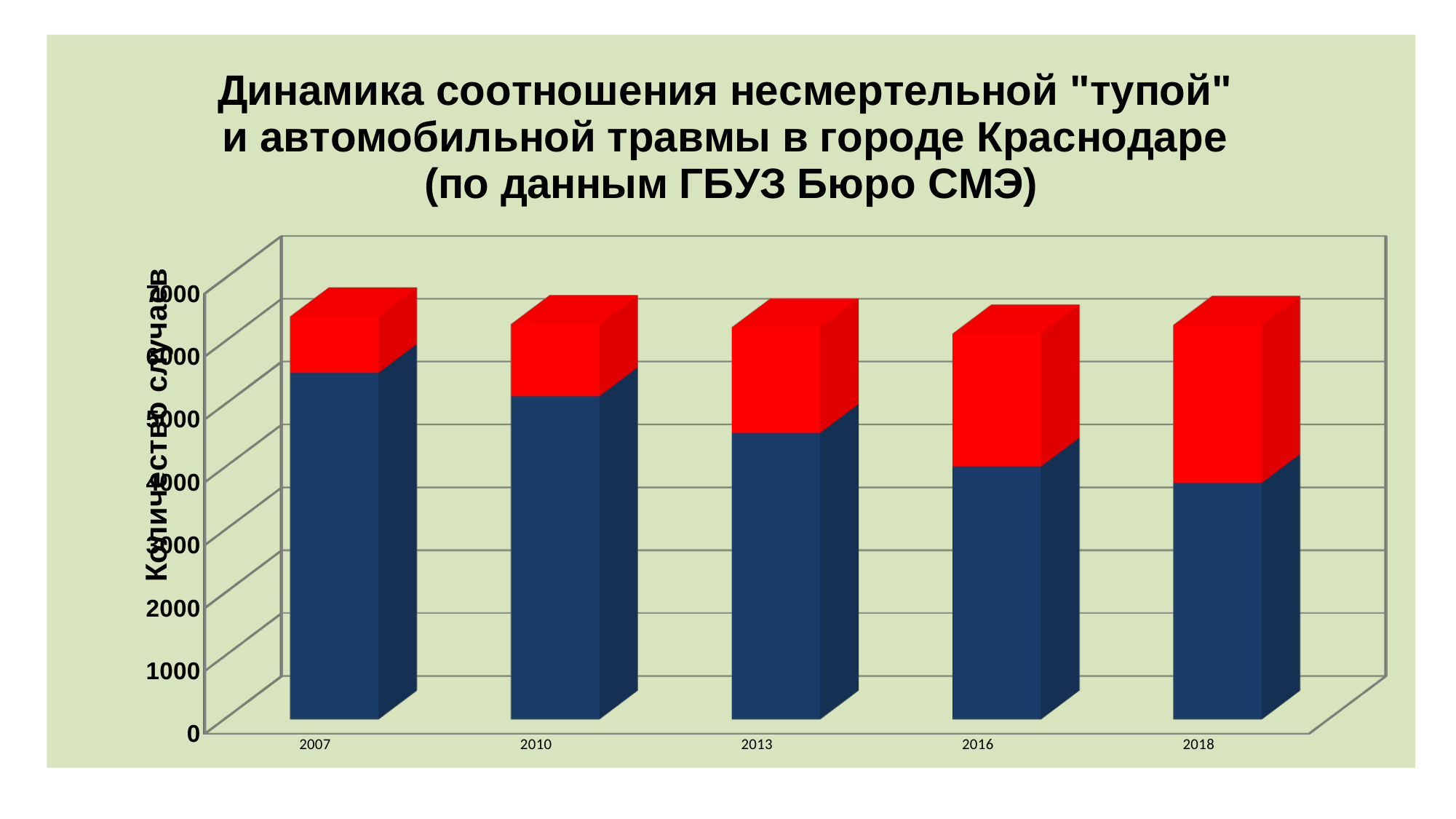
In which year is the red (upper) segment the tallest? 2018 How many years are shown along the x axis of the chart? 5 Is the value of the blue (lower) segment for 2007 greater or less than 5000? greater What is the label of the vertical axis of the chart? Количество случаев In which year is the red (upper) segment the smallest? 2007 In which year is the blue (lower) segment the tallest? 2007 What kind of chart is shown on the slide? bar chart Does the blue (lower) segment of the bars rise or fall from 2007 to 2018? fall Is the total height of the stacked bar for 2007 greater or less than 6000? greater Does the red (upper) segment of the bars rise or fall from 2007 to 2018? rise Is the value of the blue (lower) segment for 2016 greater or less than 5000? less Which years are shown on the x axis of the chart? 2007, 2010, 2013, 2016, 2018